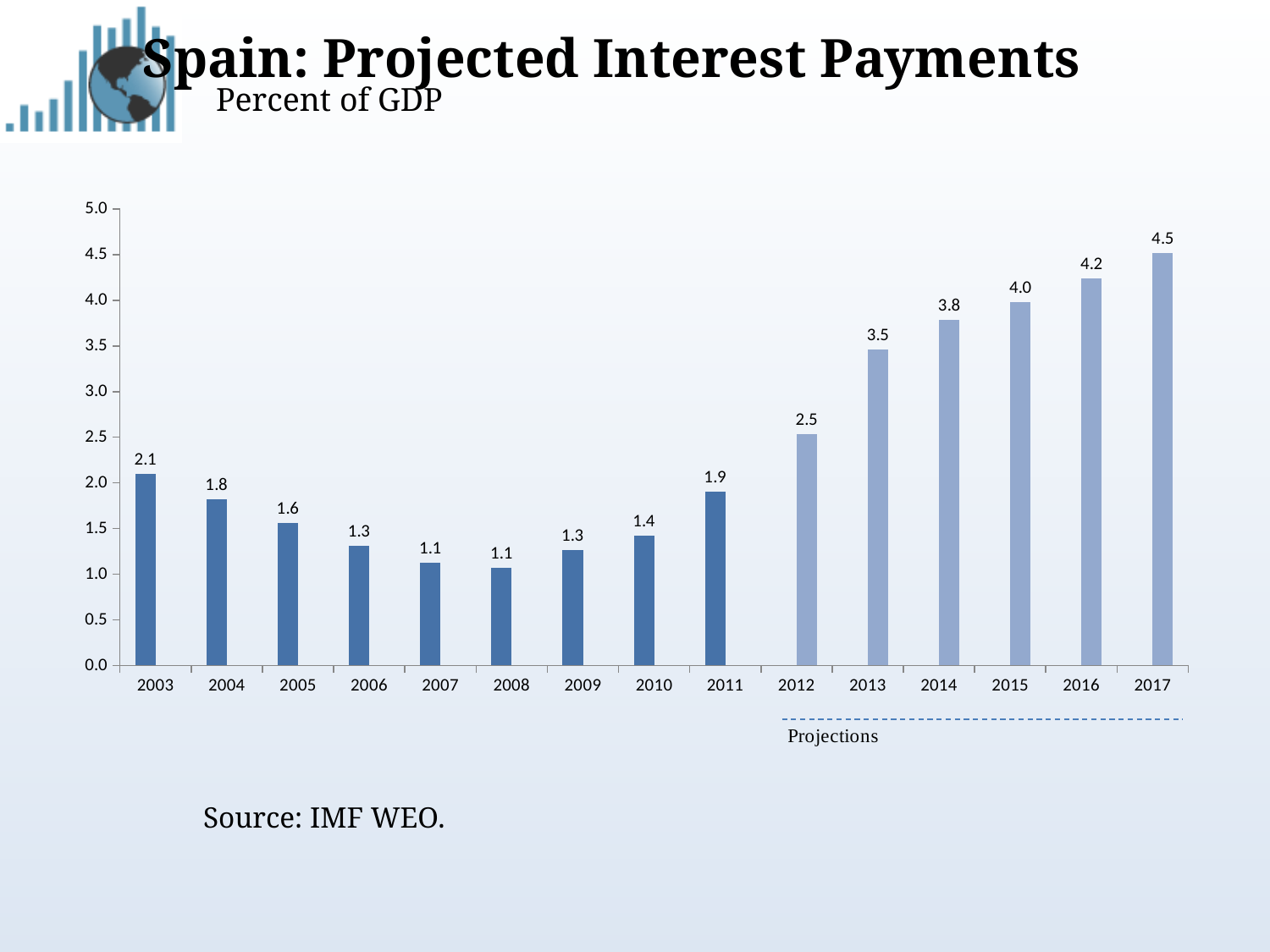
Do the values rise or fall from 2011 to 2017? Rise How many years are shown on the x axis? 15 What is the first year labelled as a projection? 2012 Which year has the larger value, 2004 or 2012? 2012 Which years share the lowest value on the chart? 2007 and 2008 What kind of chart is shown on the slide? Bar chart Which year has the highest value on the chart? 2017 What value is shown for 2011? 1.9 What is the source cited for the chart? IMF WEO What is the projected interest payment for Spain in 2017, as a percent of GDP? 4.5 What is the difference between the values for 2017 and 2011? 2.6 What value is shown for 2003? 2.1